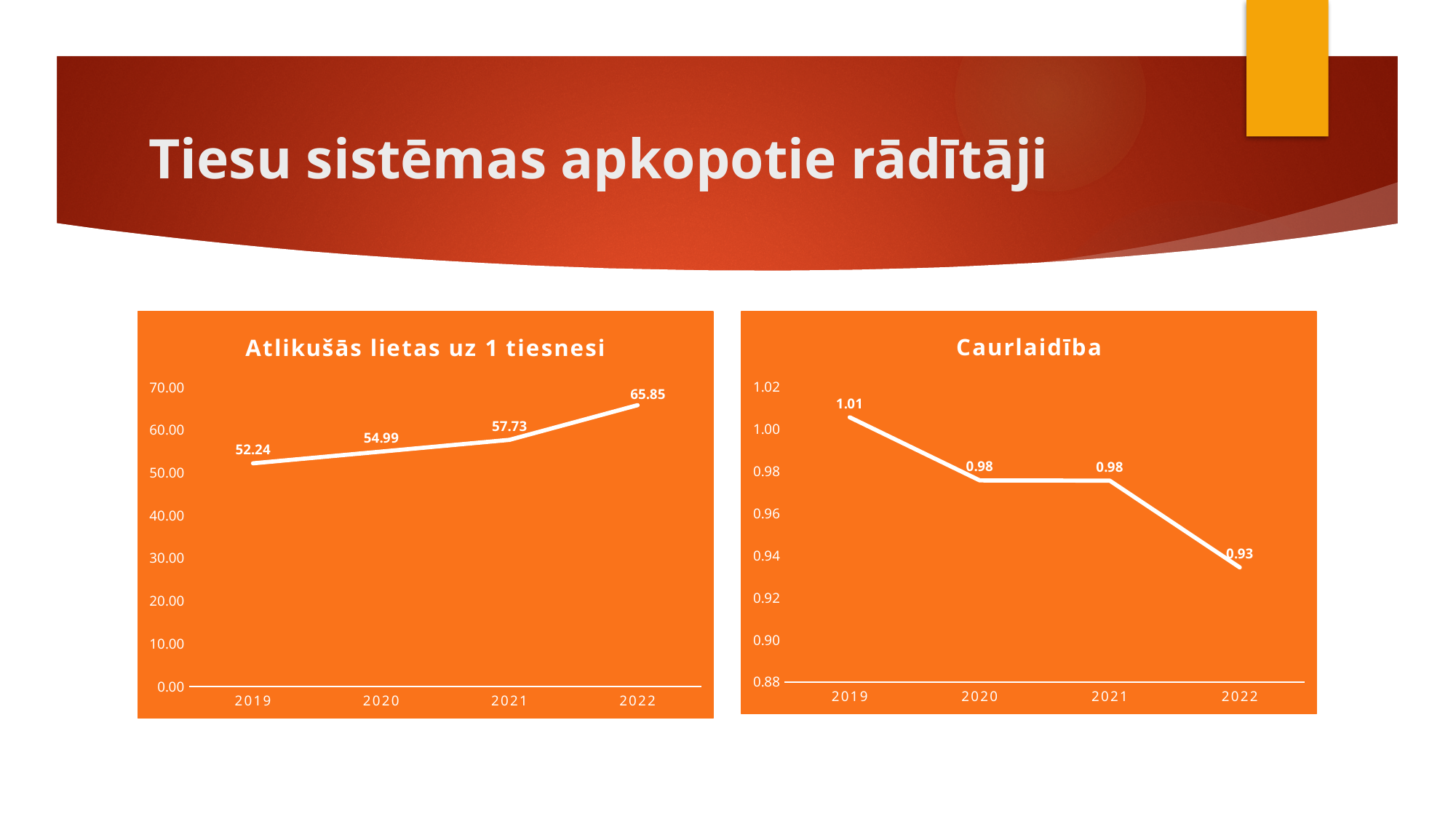
In the chart titled "Atlikušās lietas uz 1 tiesnesi", what is the value for 2022? 65.85 In the chart titled "Atlikušās lietas uz 1 tiesnesi", which year has the highest value? 2022 What kind of chart is the chart titled "Caurlaidība"? line chart In the chart titled "Atlikušās lietas uz 1 tiesnesi", what is the difference between the 2022 and 2021 values? 8.12 In the chart titled "Caurlaidība", what is the value for 2019? 1.01 In the chart titled "Caurlaidība", how many years are plotted on the x axis? 4 In the chart titled "Atlikušās lietas uz 1 tiesnesi", what is the value for 2019? 52.24 In the chart titled "Caurlaidība", is the value for 2019 larger or smaller than the value for 2022? larger In the chart titled "Caurlaidība", which year has the lowest value? 2022 In the chart titled "Atlikušās lietas uz 1 tiesnesi", which year has the lowest value? 2019 In the chart titled "Caurlaidība", what is the value for 2022? 0.93 In the chart titled "Atlikušās lietas uz 1 tiesnesi", do the values rise or fall from 2019 to 2022? rise